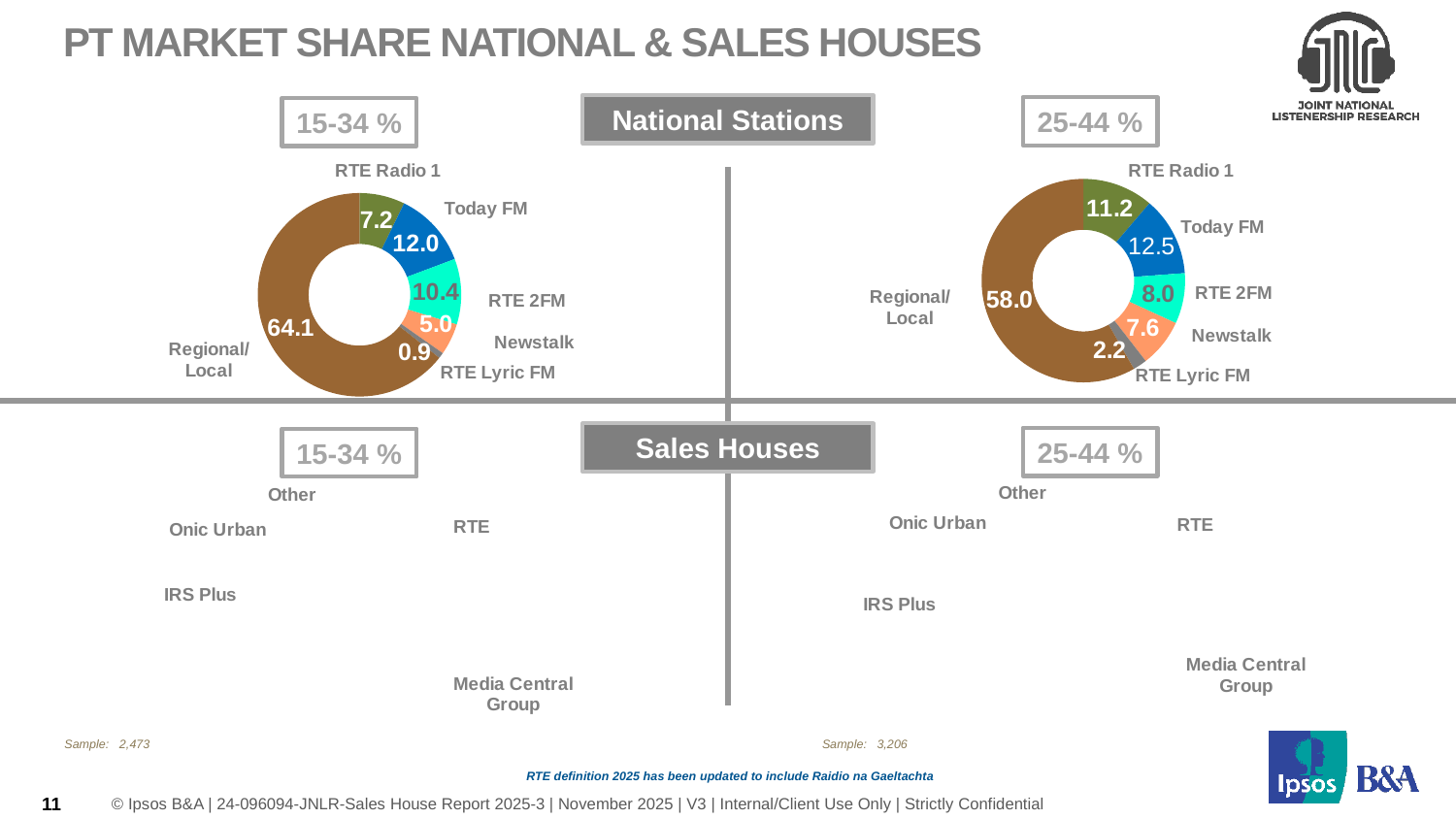
In the National Stations 15-34 % chart, what is the value for RTE Lyric FM? 0.9 How many stations are shown in the National Stations 25-44 % chart? 6 In the National Stations 25-44 % chart, what is the value for Today FM? 12.5 In the National Stations 15-34 % chart, what is the difference between Today FM and RTE 2FM? 1.6 Is the value for Regional/Local higher in the National Stations 15-34 % chart or the 25-44 % chart? 15-34 % In the National Stations 25-44 % chart, which station has the largest share? Regional/Local In the National Stations 25-44 % chart, what is the difference between RTE Radio 1 and RTE Lyric FM? 9.0 In the National Stations 15-34 % chart, which is larger, RTE Radio 1 or Newstalk? RTE Radio 1 In the National Stations 15-34 % chart, what is the value for Regional/Local? 64.1 In the National Stations 25-44 % chart, what is the value for Newstalk? 7.6 What type of chart is used for the National Stations 15-34 % data? Donut (pie) chart In the National Stations 15-34 % chart, which station has the smallest share? RTE Lyric FM